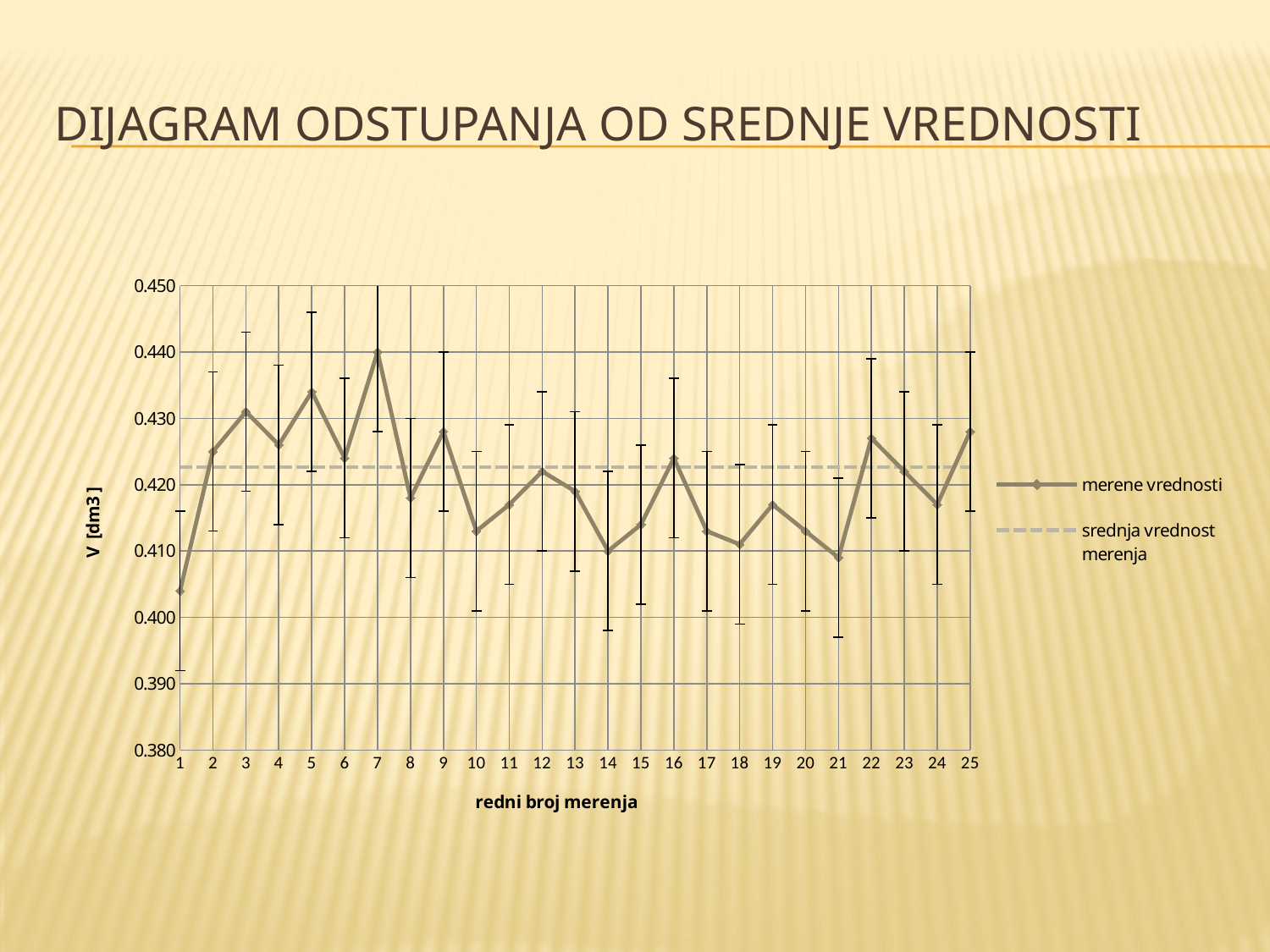
Which has the larger measured value, measurement 2 or measurement 10? measurement 2 Is the measured value for measurement 5 greater or less than 0.430? greater How many series does the legend list? 2 Is the measured value for measurement 22 greater or less than 0.420? greater Is the measured value for measurement 1 greater or less than 0.410? less How many measurement points are plotted along the x axis? 25 Which measurement number has the highest measured value? 7 What kind of chart is shown on the slide? line chart Does the measured value rise or fall from measurement 7 to measurement 8? fall What is the label of the y axis? V [dm3] Which measurement number has the lowest measured value? 1